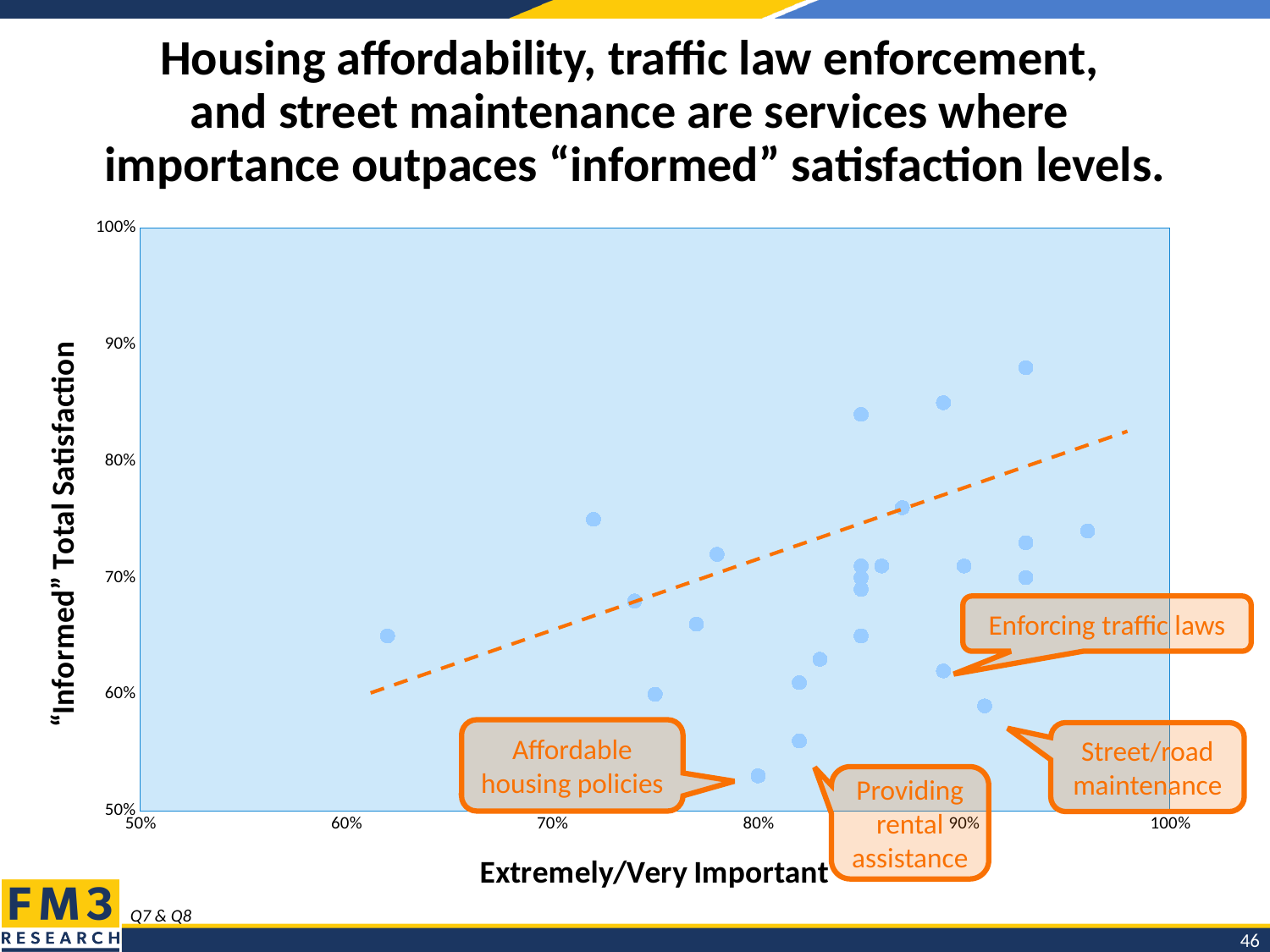
What is the title of the horizontal axis of the chart? Extremely/Very Important What kind of chart is shown on the slide? Scatter chart Is the highest "Informed" Total Satisfaction value plotted in the chart greater or less than 80%? greater Is the Extremely/Very Important value for Enforcing traffic laws greater or less than 80%? greater Is the Extremely/Very Important value for Street/road maintenance greater or less than 80%? greater Which has the higher "Informed" Total Satisfaction value, Enforcing traffic laws or Affordable housing policies? Enforcing traffic laws Does the dashed trend line in the chart rise or fall as importance increases along the x axis? Rises What is the title of the vertical axis of the chart? "Informed" Total Satisfaction